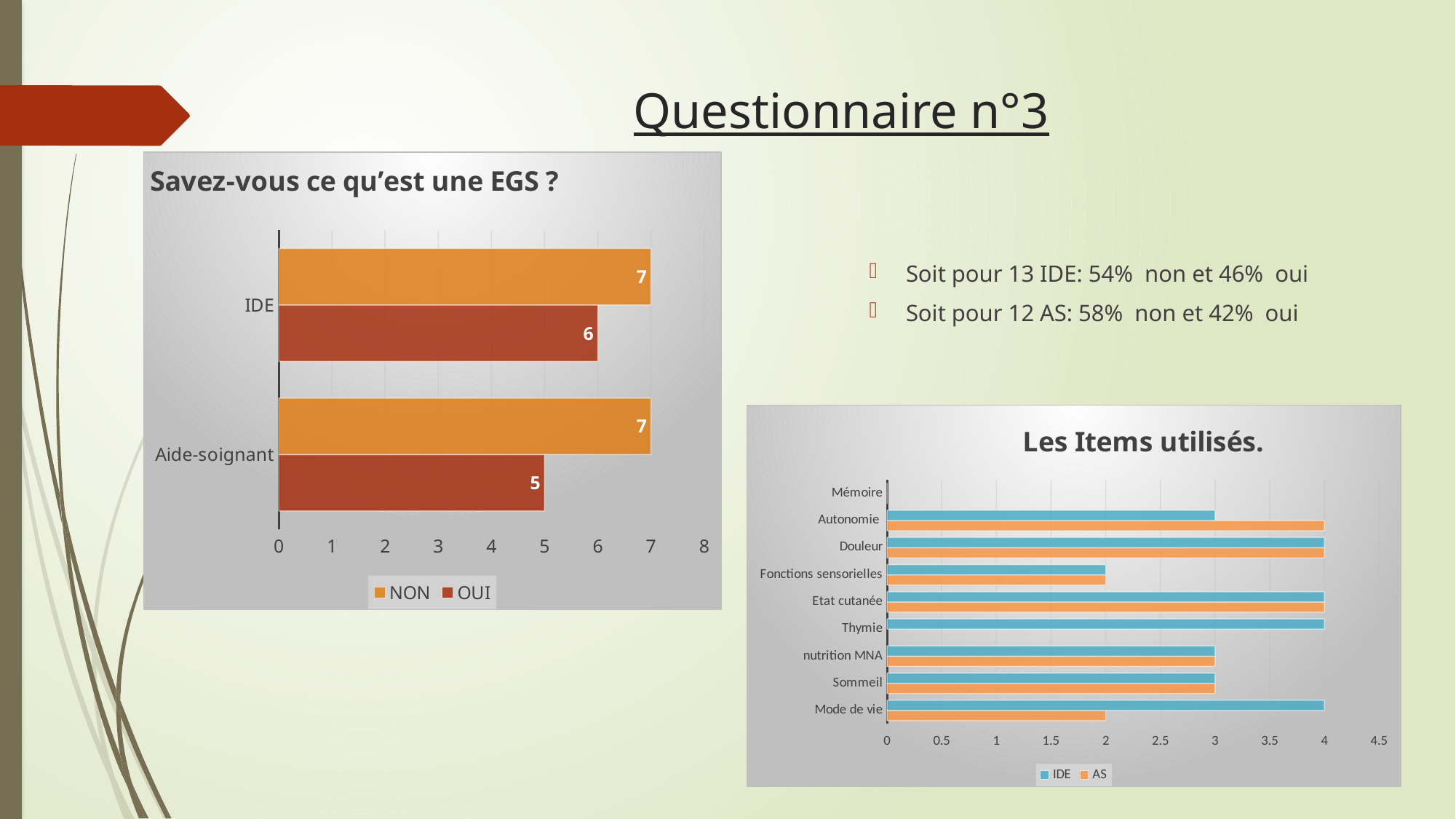
In the chart 'Les Items utilisés.', which is larger for Mode de vie, IDE or AS? IDE In the chart 'Savez-vous ce qu'est une EGS ?', what is the NON value for IDE? 7 In the chart 'Savez-vous ce qu'est une EGS ?', what is the OUI value for Aide-soignant? 5 In the chart 'Les Items utilisés.', is the IDE value for Fonctions sensorielles greater or less than 3? less In the chart 'Savez-vous ce qu'est une EGS ?', which is larger for Aide-soignant, NON or OUI? NON In the chart 'Les Items utilisés.', what is the AS value for Autonomie? 4 In the chart 'Savez-vous ce qu'est une EGS ?', how many series does the legend list? 2 What kind of chart is 'Savez-vous ce qu'est une EGS ?'? Bar chart In the chart 'Savez-vous ce qu'est une EGS ?', what is the difference between the NON and OUI values for IDE? 1 In the chart 'Les Items utilisés.', how many categories are shown on the vertical axis? 9 In the chart 'Les Items utilisés.', what is the IDE value for Mode de vie? 4 In the chart 'Les Items utilisés.', which series does the legend list first? IDE